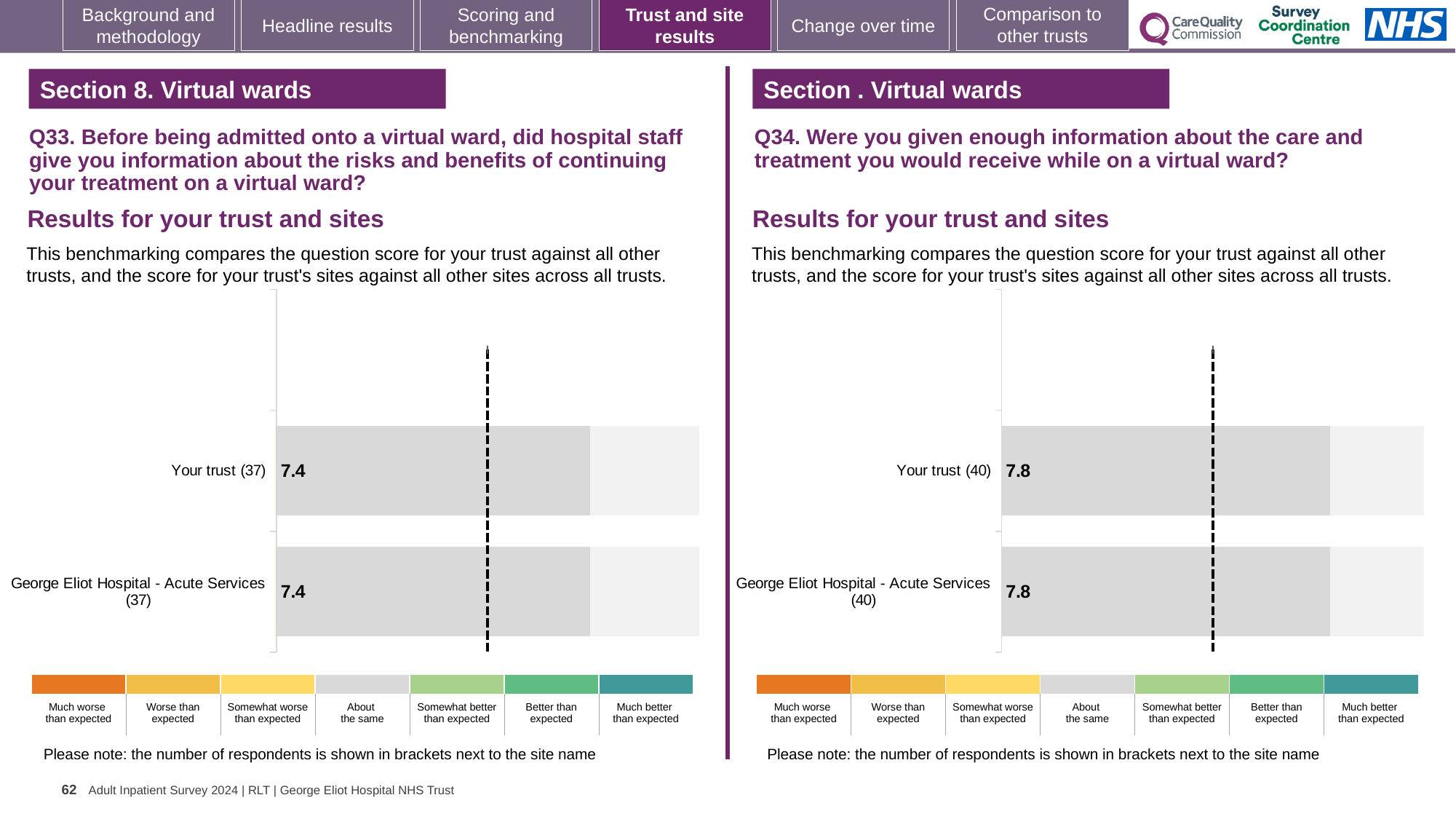
On the Q33 chart (left), what is the difference between the score for Your trust and the score for George Eliot Hospital - Acute Services? 0 How many bars are plotted on the Q33 chart (left)? 2 On the Q34 chart (right), what is the score for Your trust? 7.8 On the Q34 chart (right), what is the difference between the score for Your trust and the score for George Eliot Hospital - Acute Services? 0 What kind of chart is used on the Q33 chart (left)? Bar chart On the Q34 chart (right), what is the score for George Eliot Hospital - Acute Services? 7.8 On the Q34 chart (right), how many respondents are shown in brackets for George Eliot Hospital - Acute Services? 40 How many bars are plotted on the Q34 chart (right)? 2 On the Q33 chart (left), what is the score for Your trust? 7.4 On the Q33 chart (left), how many respondents are shown in brackets for Your trust? 37 Is the score for Your trust on the Q34 chart (right) larger or smaller than the score for Your trust on the Q33 chart (left)? Larger On the Q33 chart (left), what is the score for George Eliot Hospital - Acute Services? 7.4